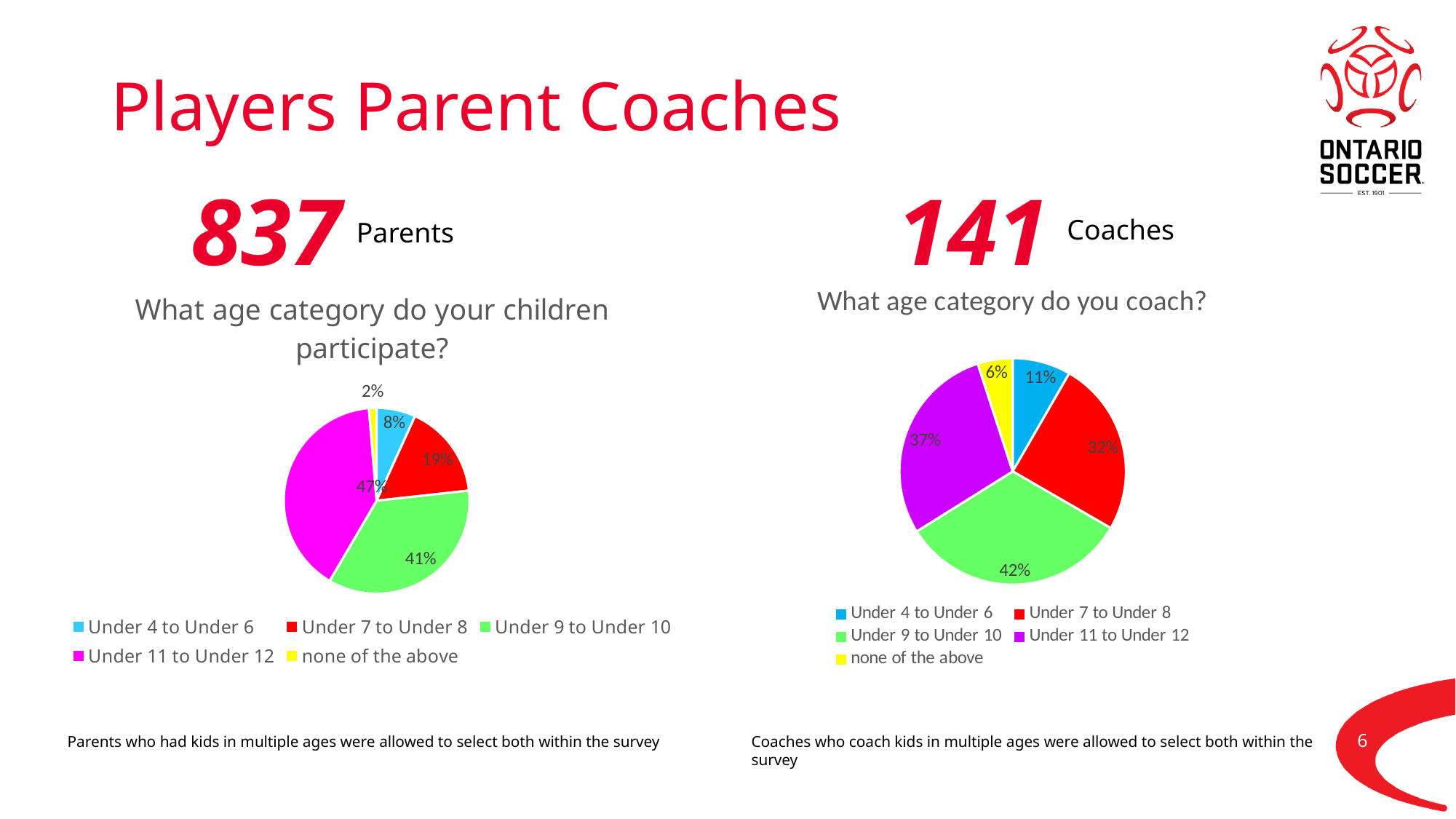
In the 'What age category do you coach?' chart, which is larger: Under 7 to Under 8 or Under 11 to Under 12? Under 11 to Under 12 In the 'What age category do your children participate?' chart, which category has the smallest share? none of the above In the 'What age category do your children participate?' chart, what share is Under 7 to Under 8? 19% What type of chart is the 'What age category do your children participate?' chart? Pie chart How many categories does the legend of the 'What age category do you coach?' chart list? 5 In the 'What age category do your children participate?' chart, what share is Under 11 to Under 12? 47% In the 'What age category do your children participate?' chart, what is the difference between the Under 9 to Under 10 share and the Under 4 to Under 6 share? 33% In the 'What age category do you coach?' chart, what share is Under 9 to Under 10? 42% In the 'What age category do you coach?' chart, which category has the largest share? Under 9 to Under 10 In the 'What age category do you coach?' chart, what is the difference between the Under 11 to Under 12 share and the none of the above share? 31% In the 'What age category do your children participate?' chart, which category has the largest share? Under 11 to Under 12